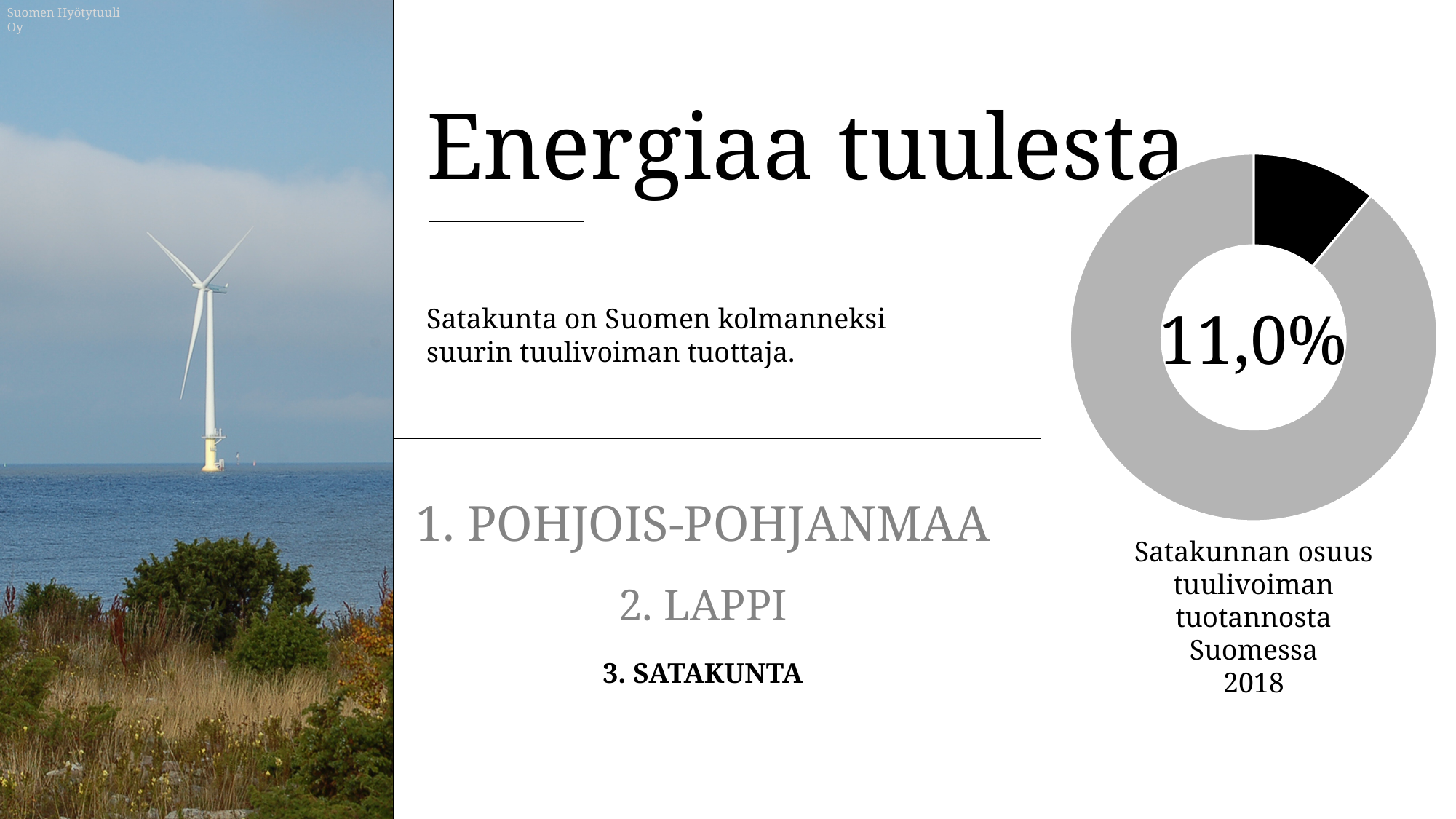
What kind of chart is shown on the right side of the slide? donut chart What value is printed in the centre of the donut chart? 11,0% In the donut chart, which slice is larger, the black one or the grey one? the grey one Which slice of the donut chart is the smallest? the black slice (Satakunta) Which slice of the donut chart is the largest? the grey slice Which year does the donut chart refer to? 2018 Is the black slice of the donut chart greater or less than 50% of the whole? less How many slices does the donut chart have? 2 According to the donut chart, what is Satakunta's share of Finland's wind power production in 2018? 11,0% What caption is written below the donut chart? Satakunnan osuus tuulivoiman tuotannosta Suomessa 2018